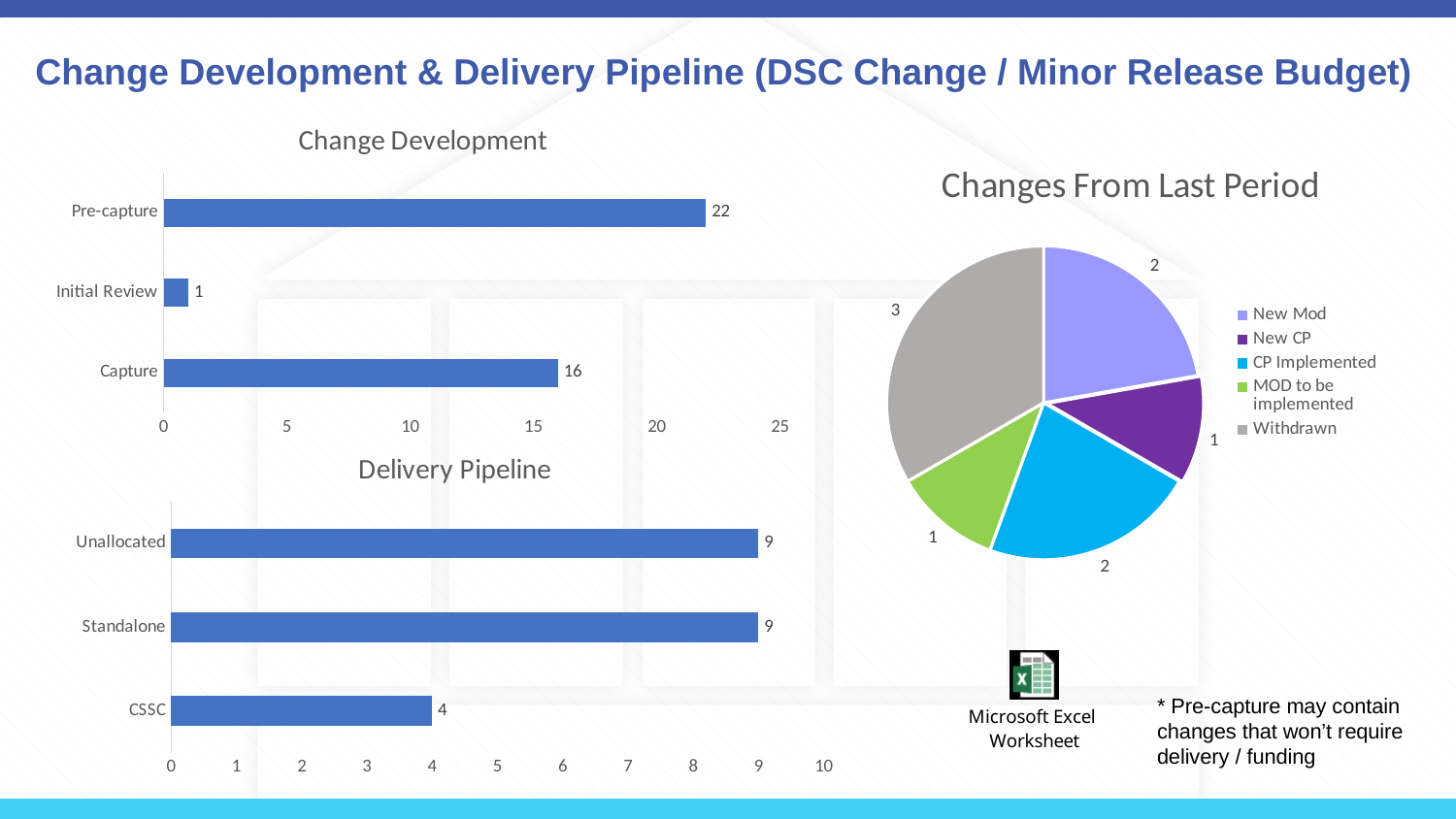
In the Changes From Last Period chart, what is the value for Withdrawn? 3 What kind of chart is the Delivery Pipeline chart? Bar chart In the Changes From Last Period chart, how many entries does the legend list? 5 In the Delivery Pipeline chart, what is the value for CSSC? 4 In the Change Development chart, what is the value for Pre-capture? 22 In the Change Development chart, which category has the lowest value? Initial Review In the Delivery Pipeline chart, what is the difference between Unallocated and CSSC? 5 In the Changes From Last Period chart, what is the total of all slices? 9 In the Delivery Pipeline chart, which category has the lowest value? CSSC In the Change Development chart, what is the difference between Pre-capture and Capture? 6 In the Change Development chart, how many categories are shown? 3 In the Change Development chart, what is the value for Capture? 16